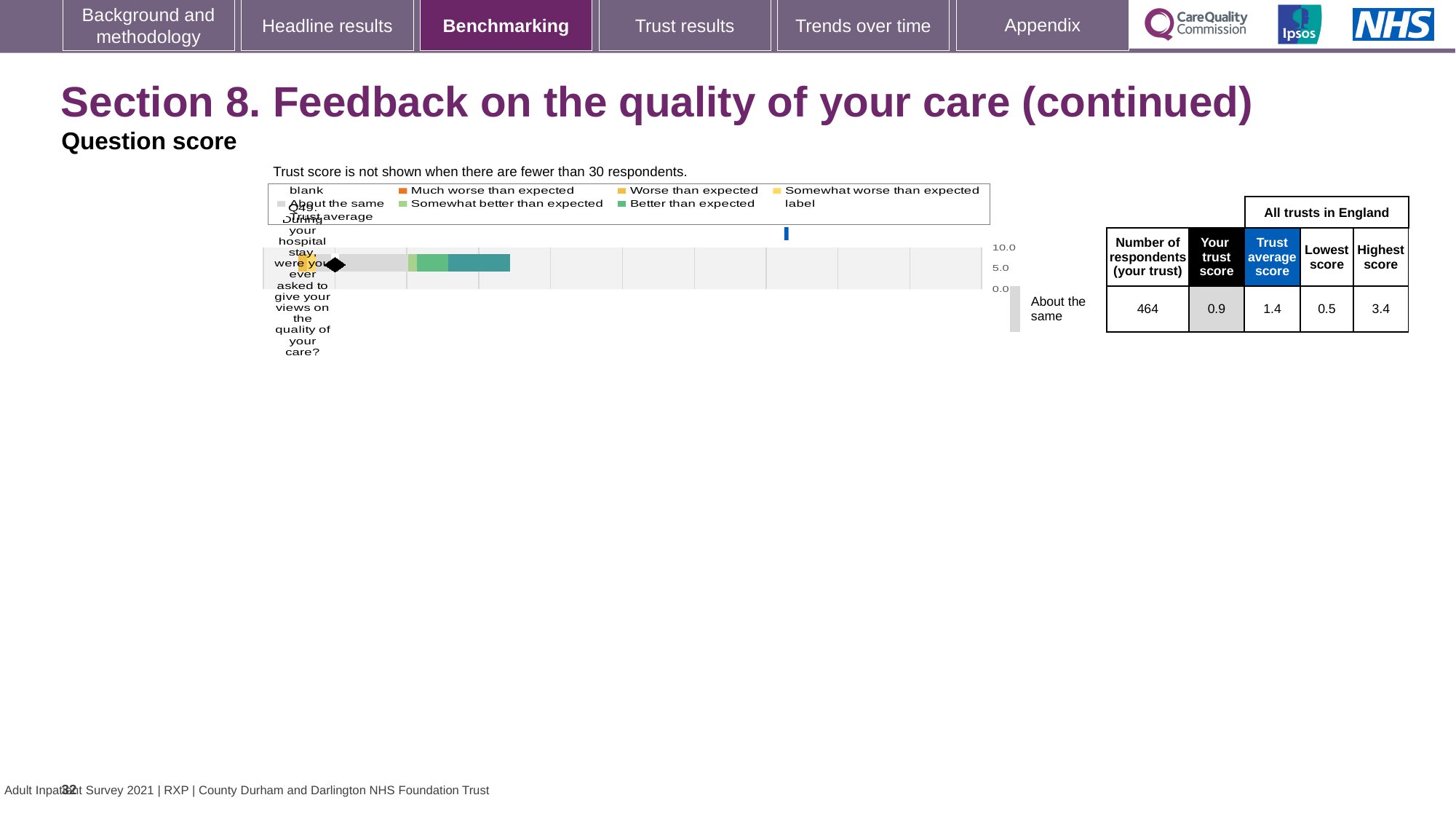
How many questions are plotted on the benchmarking chart? 1 Is the trust's score for Q49 greater or less than 5.0 on the chart axis? less By how much does the trust average score exceed the trust's own score for Q49? 0.5 Which benchmarking category is the trust's Q49 result placed in? About the same Which is larger for Q49: the trust's own score or the trust average score? Trust average score What kind of chart is used to show the Q49 benchmarking result? bar chart What is the difference between the highest and lowest scores for Q49 across all trusts in England? 2.9 How many respondents from the trust answered Q49? 464 What is the trust average score for Q49 across all trusts in England? 1.4 What is the highest score among all trusts in England for Q49? 3.4 What is the trust's score for Q49 (During your hospital stay, were you ever asked to give your views on the quality of your care?)? 0.9 What is the lowest score among all trusts in England for Q49? 0.5